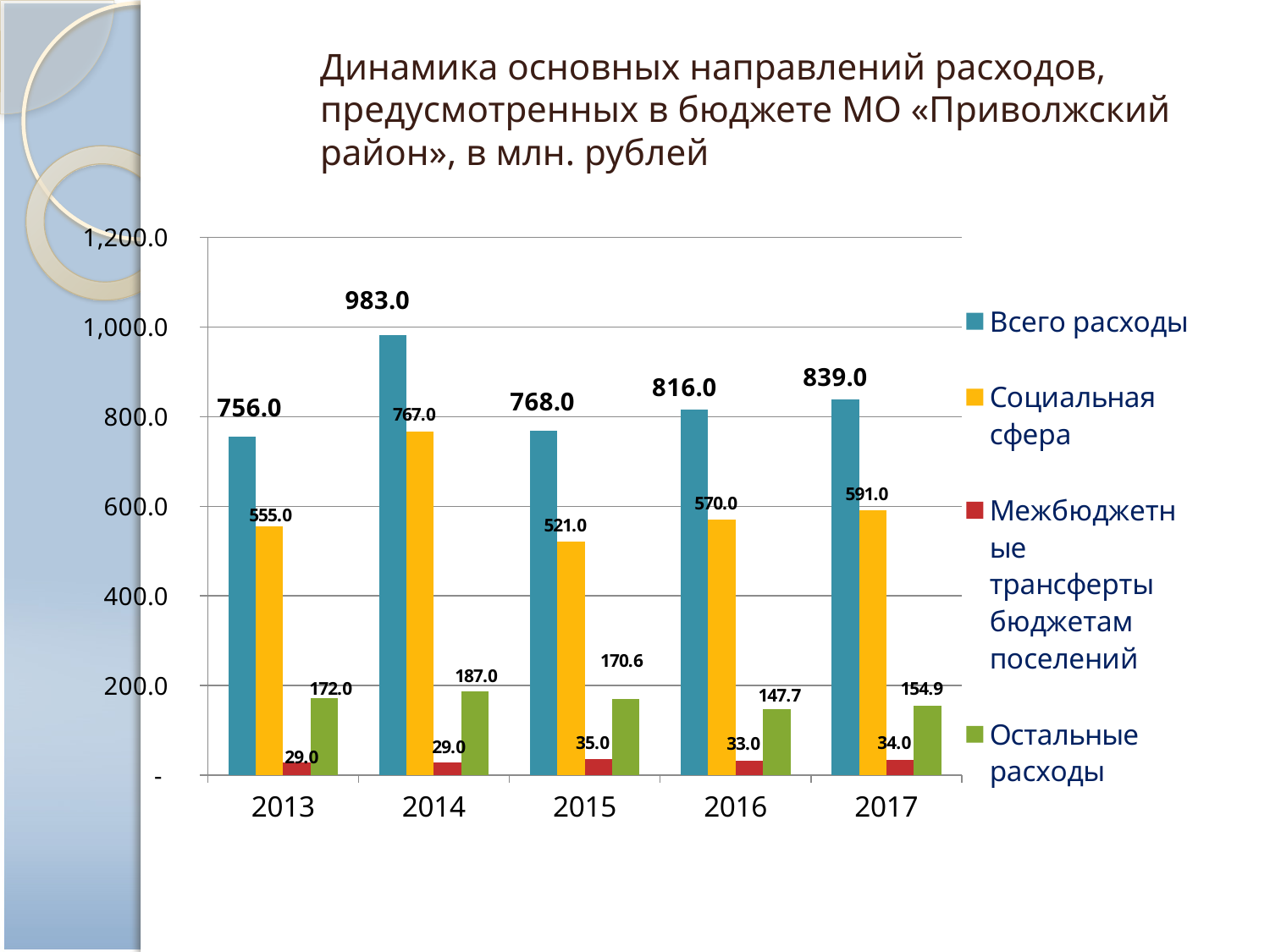
What is the value of Межбюджетные трансферты бюджетам поселений for 2016? 33.0 What kind of chart is shown on the slide? Bar chart Which is larger: Остальные расходы in 2014 or in 2016? 2014 In which year is Всего расходы highest? 2014 How many series does the legend list? 4 In which year is Социальная сфера lowest? 2015 Does Всего расходы rise or fall from 2015 to 2017? Rise What is the value of Остальные расходы for 2015? 170.6 What is the value of Социальная сфера for 2017? 591.0 What is the value of Всего расходы for 2014? 983.0 What is the difference between Всего расходы in 2017 and in 2013? 83.0 How many years are shown on the x axis? 5